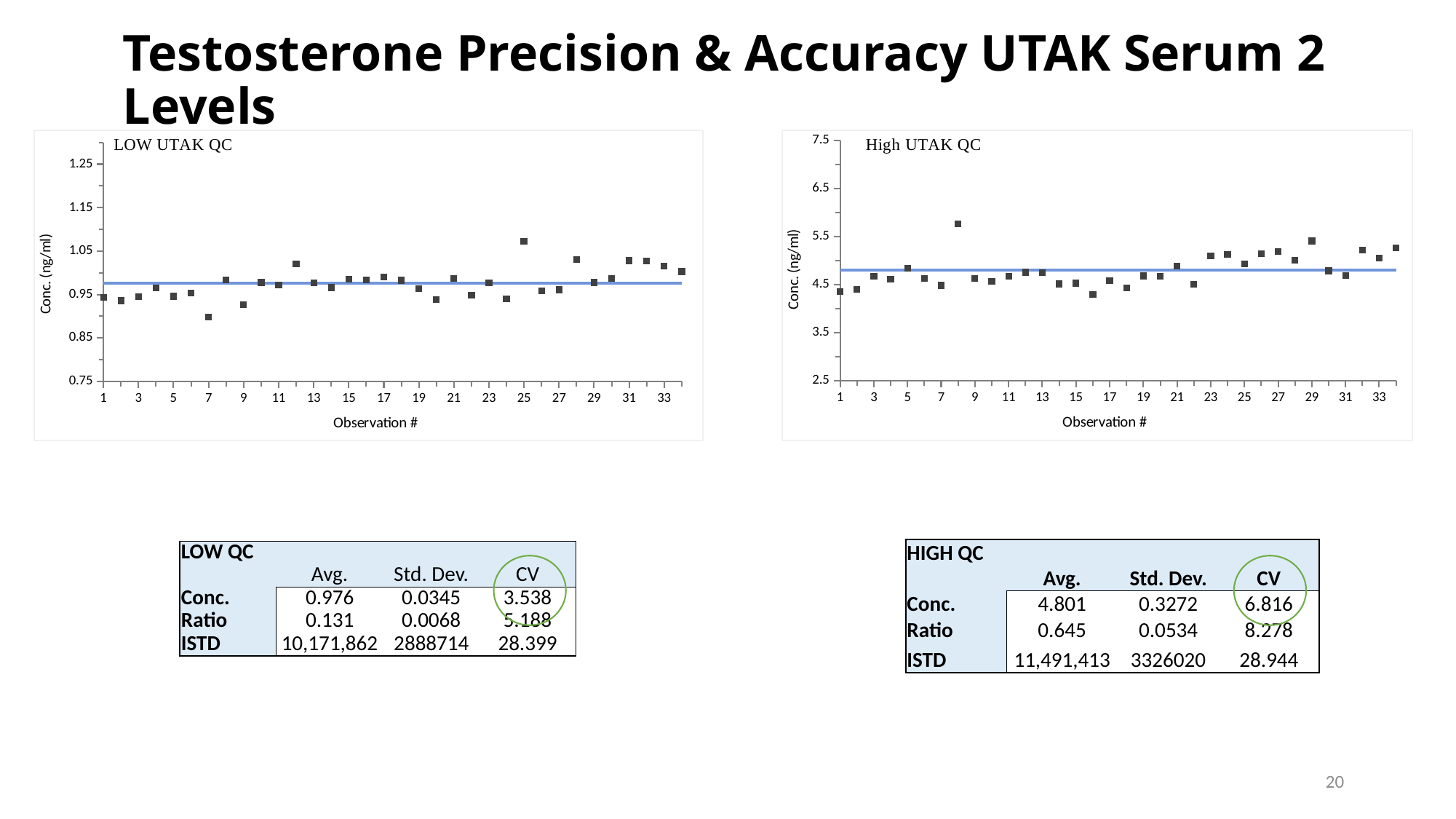
In the High UTAK QC chart, which observation number has the highest concentration? 8 What is the x-axis label on the LOW UTAK QC chart? Observation # In the LOW UTAK QC chart, which observation number has the lowest concentration? 7 In the LOW UTAK QC chart, is the value for observation 25 greater or less than 1.05? greater What is the y-axis label on the High UTAK QC chart? Conc. (ng/ml) In the LOW UTAK QC chart, is the value for observation 7 greater or less than 0.95? less In the High UTAK QC chart, is the value for observation 16 greater or less than 4.5? less In the LOW UTAK QC chart, which observation number has the highest concentration? 25 What kind of chart is the LOW UTAK QC chart? Scatter chart In the High UTAK QC chart, which is larger, the value for observation 8 or the value for observation 16? Observation 8 In the High UTAK QC chart, do the concentration values generally rise or fall from observation 1 to observation 33? Rise